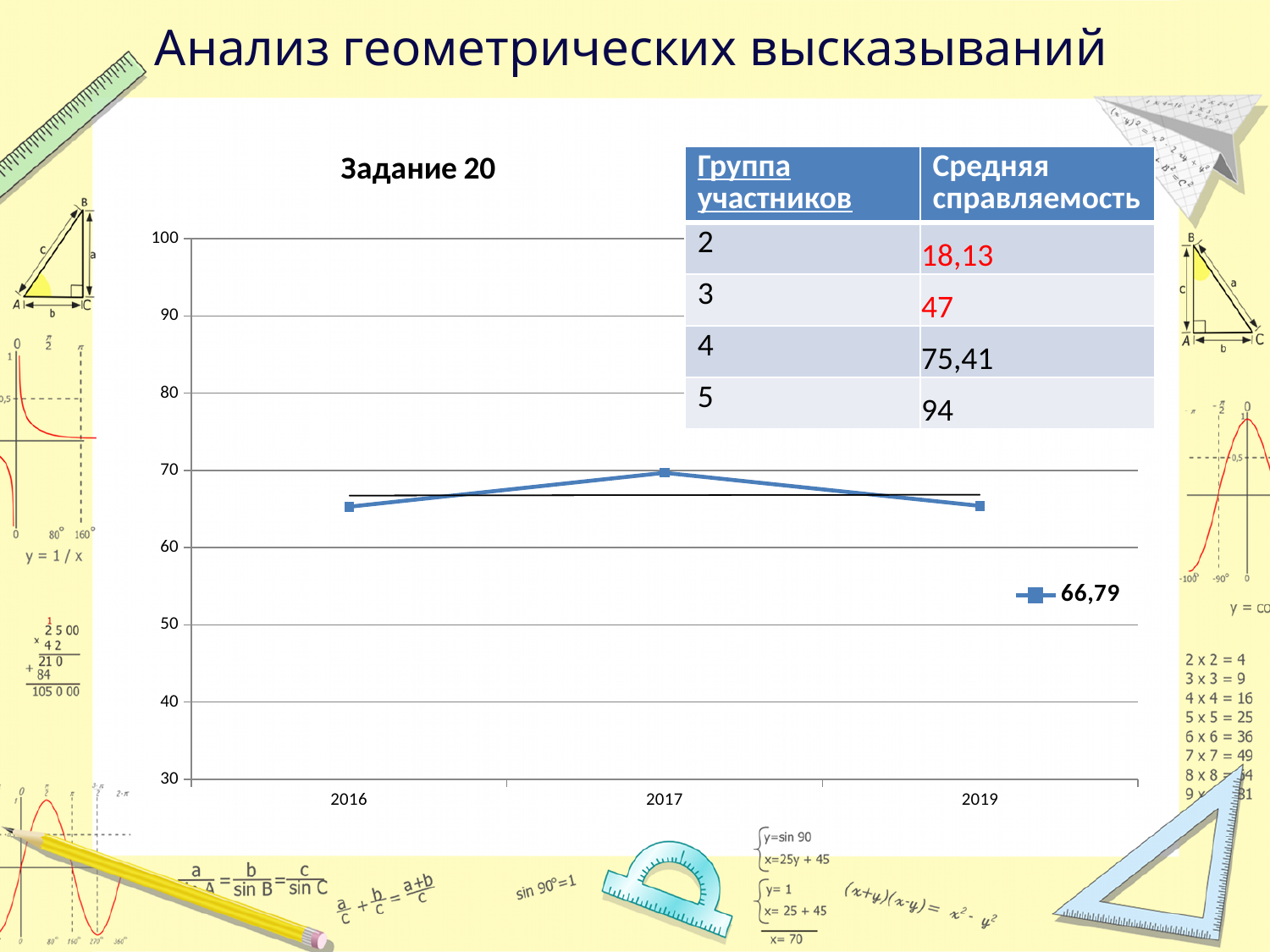
How many series does the chart legend list? 1 Is the value for 2017 greater or less than 60? greater How many points are plotted on the line in the chart? 3 Which year has the highest value in the chart? 2017 Does the line rise or fall from 2017 to 2019? fall Is the value for 2019 greater or less than 70? less Does the line rise or fall from 2016 to 2017? rise Is the value for 2016 greater or less than 70? less What is the title of the chart? Задание 20 What is the legend entry shown for the series in the chart? 66,79 What kind of chart is shown on the slide? line chart Which is larger, the value for 2016 or the value for 2017? 2017